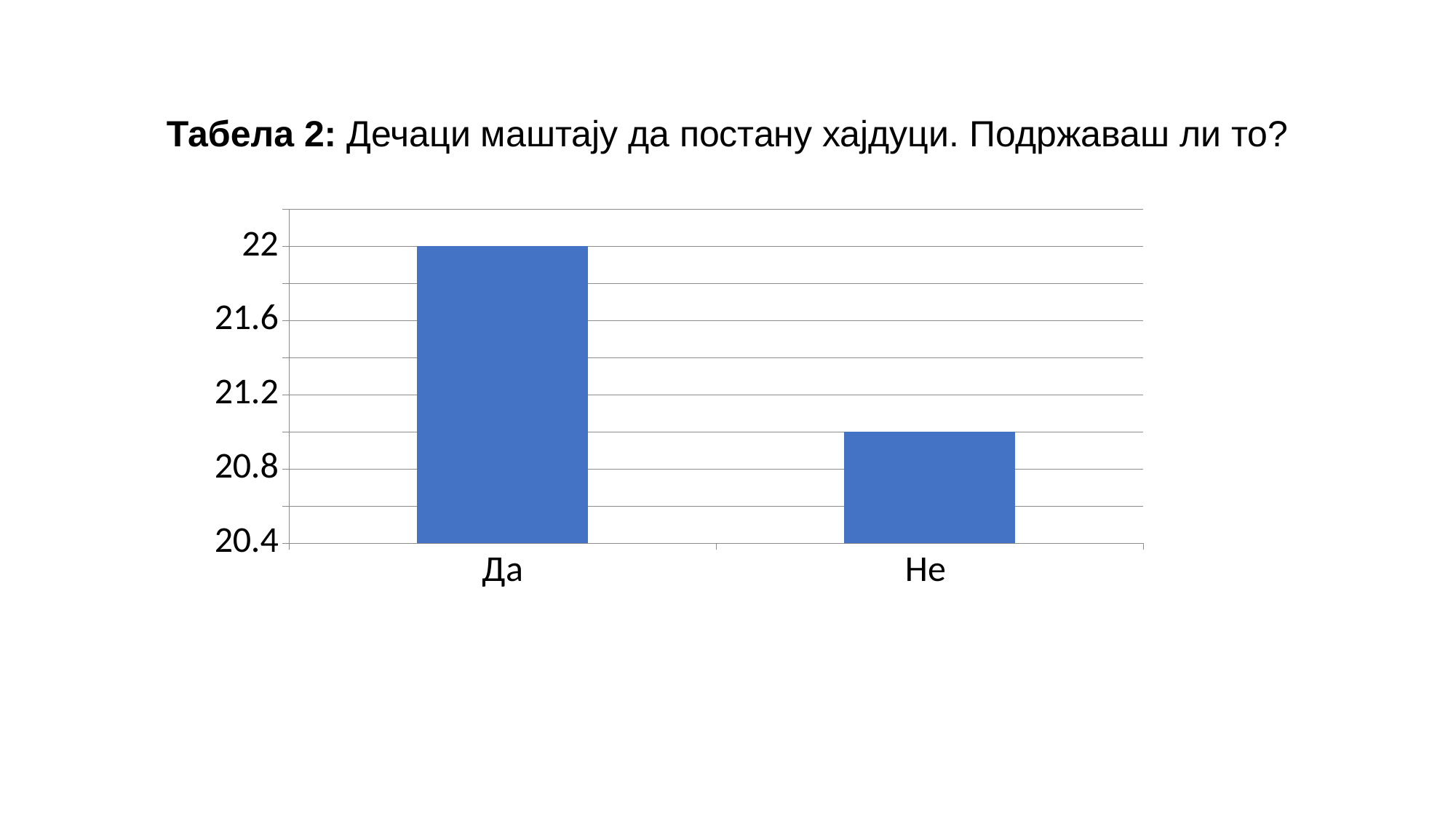
What kind of chart is shown on the slide? bar chart What is the lowest value labelled on the vertical axis of the chart? 20.4 Which category has the highest bar in the chart? Да What is the value for Да in the chart? 22 What colour are the bars in the chart? blue How many categories are shown on the x axis of the chart? 2 Which category has the lowest bar in the chart? Не Is the value for Не greater or less than 21.2? less Is the value for Не greater or less than 20.8? greater Which is larger, the value for Да or the value for Не? Да